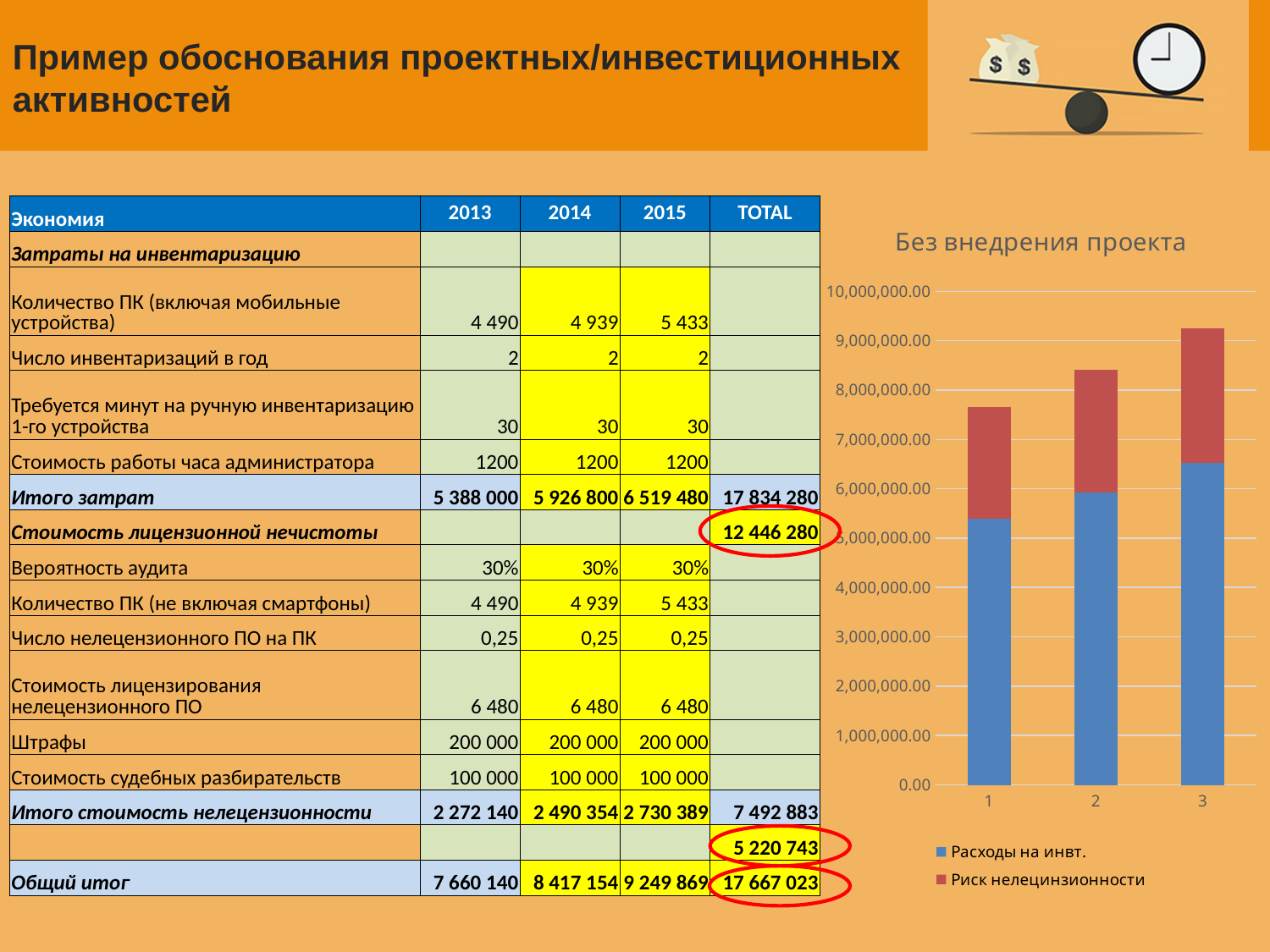
How many series does the chart legend list? 2 Which series is shown in blue in the chart? Расходы на инвт. What is the title of the chart? Без внедрения проекта Which category has the shortest stacked bar? 1 Is the value of Расходы на инвт. for category 3 greater or less than 6,000,000.00? greater In category 1, which series has the larger value: Расходы на инвт. or Риск нелецинзионности? Расходы на инвт. What kind of chart is shown on the slide? Stacked bar chart Do the total bar heights rise or fall from category 1 to category 3? Rise How many categories are shown on the x axis of the chart? 3 Is the value of Расходы на инвт. for category 1 greater or less than 5,000,000.00? greater Is the total height of the stacked bar for category 3 greater or less than 9,000,000.00? greater Which category has the tallest stacked bar? 3